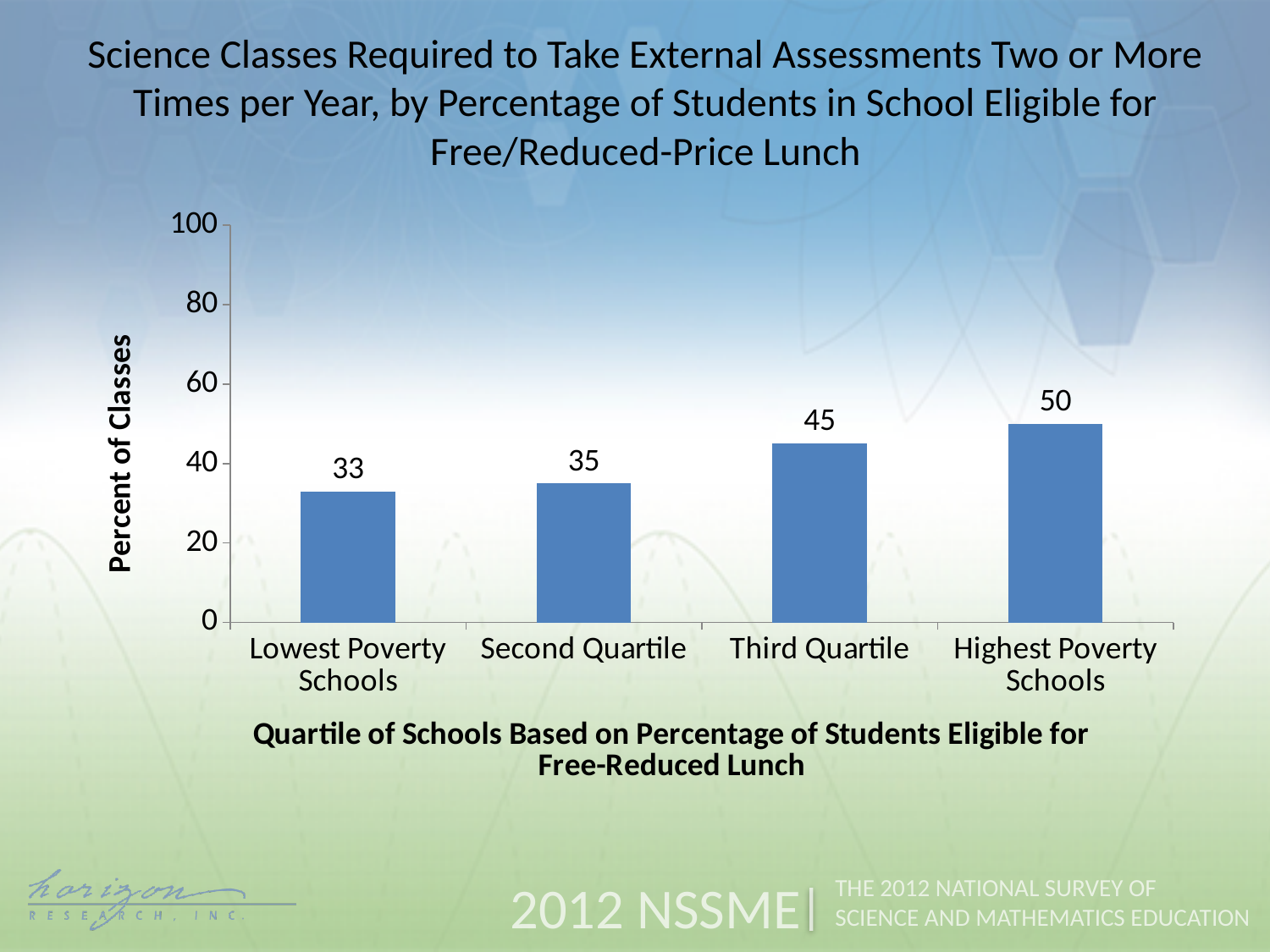
What is the difference between the values for Highest Poverty Schools and Lowest Poverty Schools? 17 Do the values rise or fall from Lowest Poverty Schools to Highest Poverty Schools? rise Which category has the highest value? Highest Poverty Schools How many categories are shown on the x axis? 4 What is the value for Third Quartile? 45 Which is larger, the value for Third Quartile or the value for Second Quartile? Third Quartile Which category has the lowest value? Lowest Poverty Schools What is the value for Highest Poverty Schools? 50 What kind of chart is shown on the slide? bar chart What is the value for Lowest Poverty Schools? 33 Is the value for Third Quartile greater or less than 40? greater What is the value for Second Quartile? 35